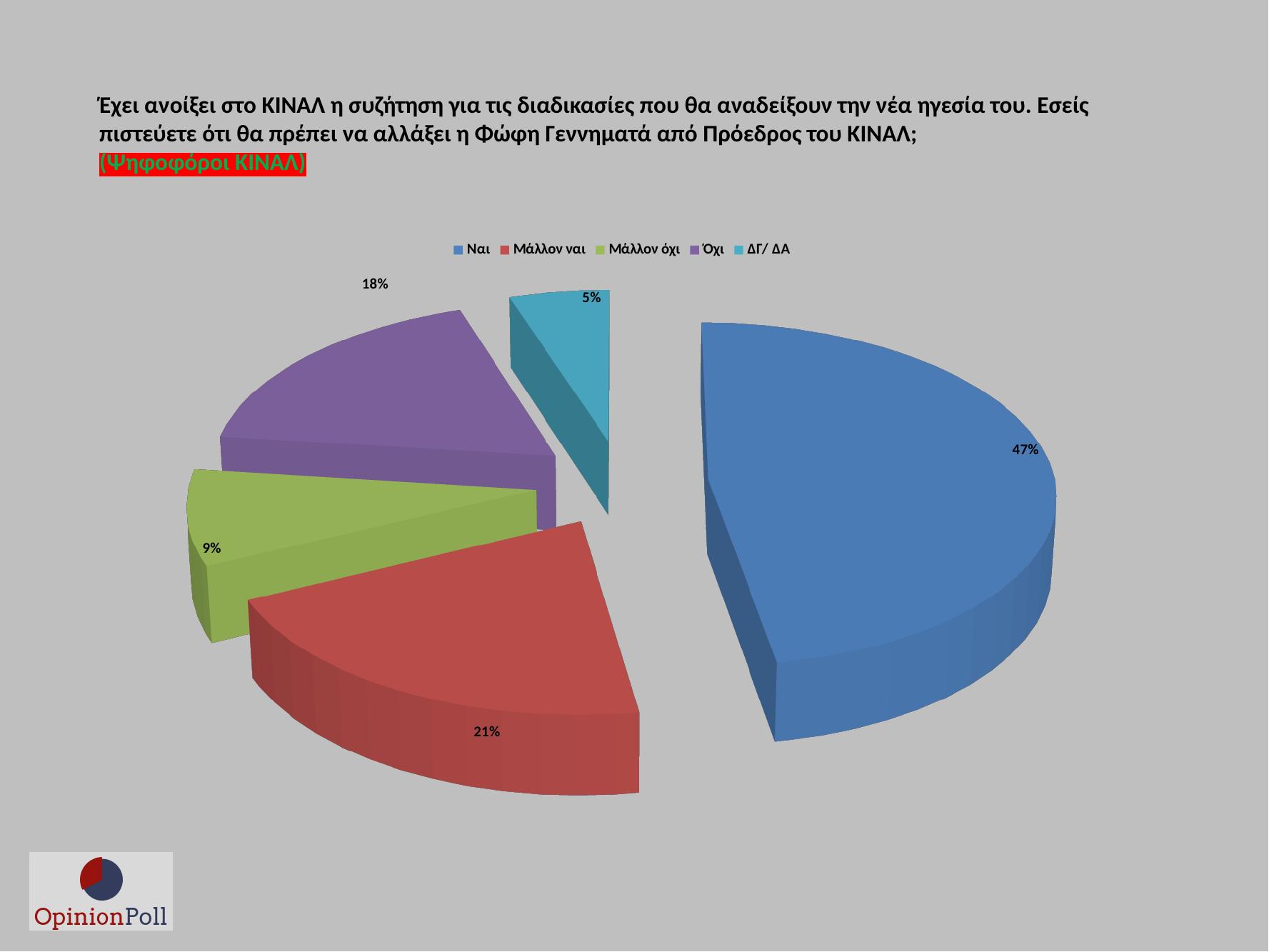
What percentage is shown for "ΔΓ/ ΔΑ"? 5% Which is larger, the share for "Μάλλον ναι" or the share for "Όχι"? Μάλλον ναι What percentage is shown for "Όχι"? 18% What type of chart is shown on the slide? Pie chart What colour is the "Όχι" slice in the pie chart? Purple Which category has the smallest share of the pie? ΔΓ/ ΔΑ What percentage is shown for "Μάλλον όχι"? 9% Which category has the largest share of the pie? Ναι What percentage is shown for "Μάλλον ναι"? 21% How many slices does the pie chart have? 5 What percentage of the pie chart is the "Ναι" slice? 47% What is the difference in percentage points between "Ναι" and "Όχι"? 29